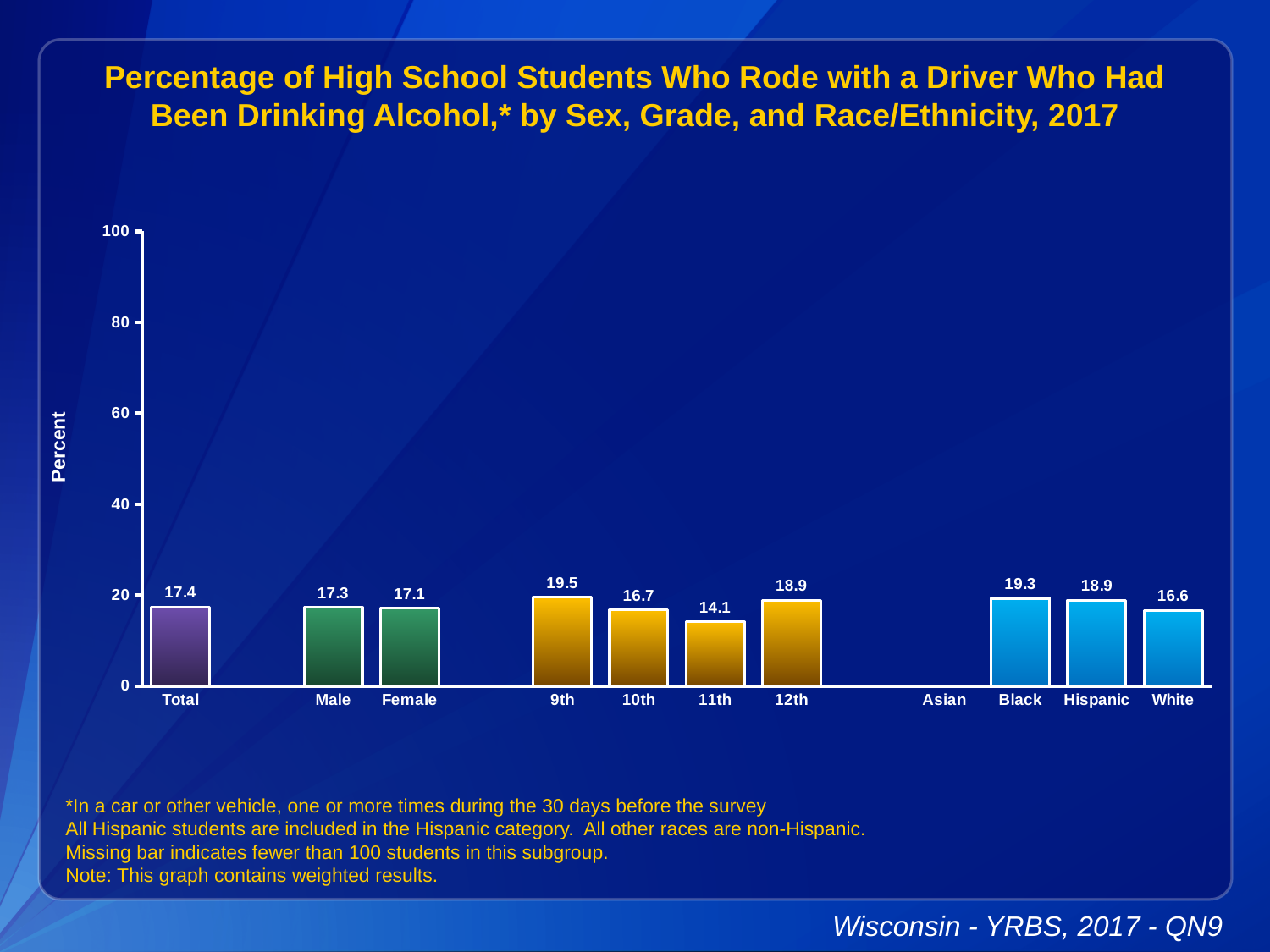
Is the value for 12th grade greater or less than 20? less What is the value for Hispanic students? 18.9 What is the value for Total? 17.4 What is the value for 11th grade? 14.1 What is the difference between the values for 9th and 11th grade? 5.4 Which category on the x axis has no bar? Asian Which category with a bar has the lowest value? 11th What is the label on the y axis? Percent What is the difference between the values for Male and Female? 0.2 What kind of chart is shown? bar chart Which is larger, the value for Black or the value for White? Black Which category has the highest value? 9th